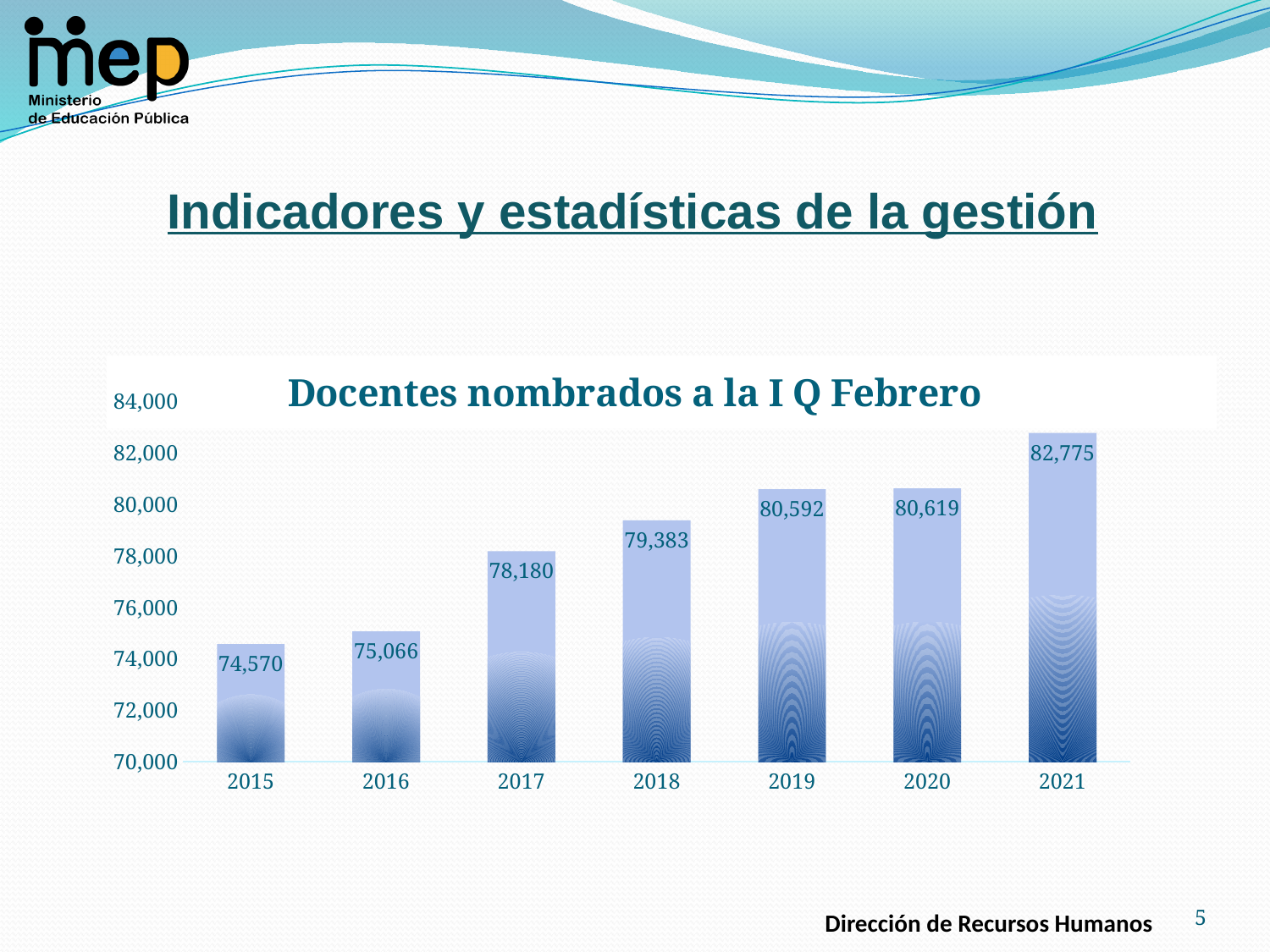
Is the value for 2019 greater or less than 80,000? greater How many years are shown on the x axis? 7 What is the title of the chart? Docentes nombrados a la I Q Febrero What is the value for 2020? 80,619 What is the difference between the values for 2019 and 2018? 1,209 What is the difference between the values for 2021 and 2015? 8,205 What is the value for 2017? 78,180 Which year has the lowest value? 2015 Which is larger, the value for 2016 or the value for 2018? 2018 Which year has the highest value? 2021 Do the values rise or fall from 2015 to 2021? rise What kind of chart is this? bar chart